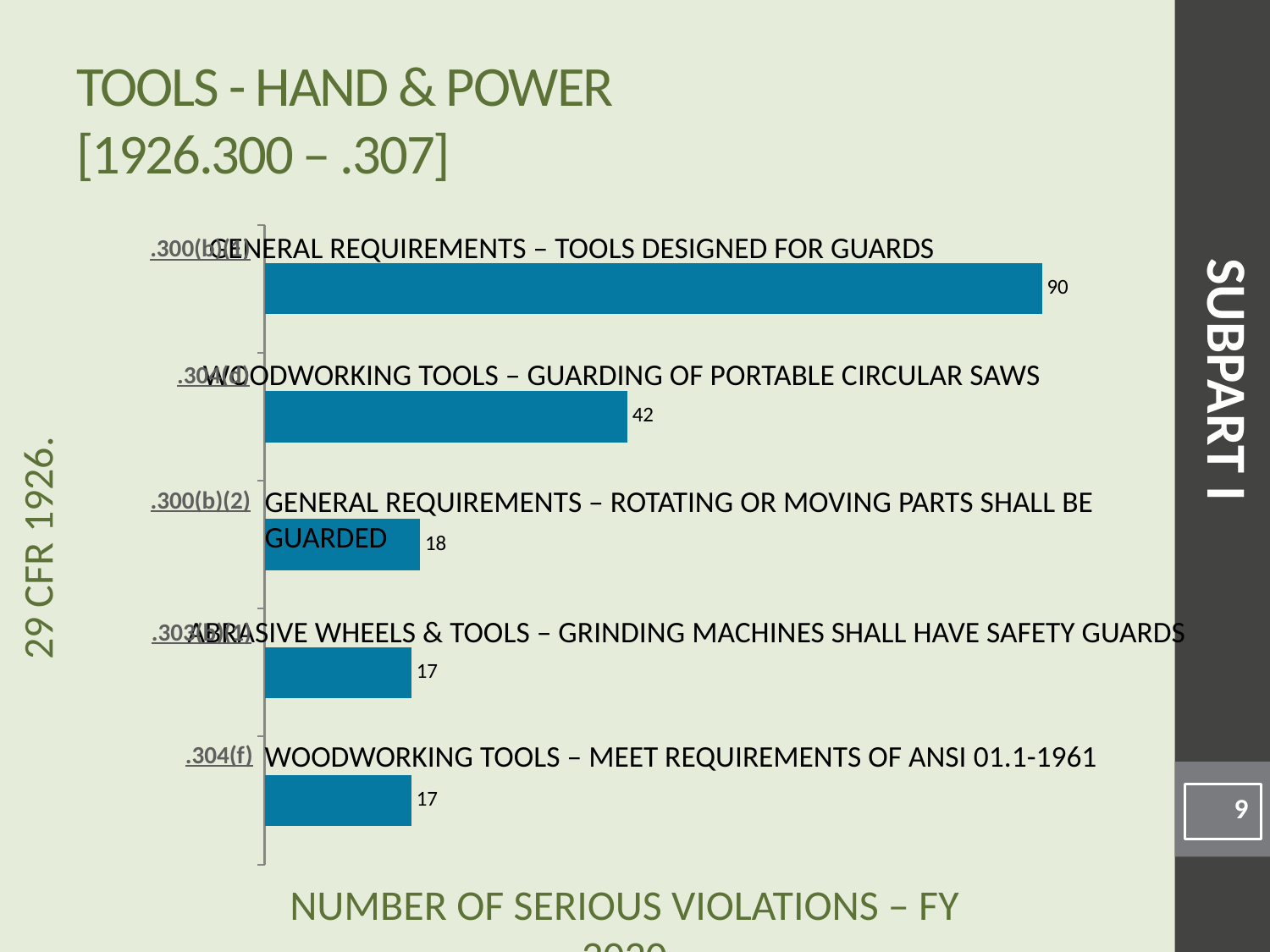
What is the value for Woodworking Tools – Guarding of Portable Circular Saws? 42 What is the difference between the values for Woodworking Tools – Guarding of Portable Circular Saws and .300(b)(2) Rotating or Moving Parts Shall Be Guarded? 24 What is the value for .304(f) Woodworking Tools – Meet Requirements of ANSI 01.1-1961? 17 How many serious violations are shown for General Requirements – Tools Designed for Guards? 90 Which is larger: the value for Woodworking Tools – Guarding of Portable Circular Saws or the value for .300(b)(2) Rotating or Moving Parts Shall Be Guarded? Woodworking Tools – Guarding of Portable Circular Saws What kind of chart is shown on the slide? Bar chart What is the lowest value shown on the chart? 17 What is the value for .300(b)(2) General Requirements – Rotating or Moving Parts Shall Be Guarded? 18 Which category has the highest number of serious violations? General Requirements – Tools Designed for Guards What is the difference between the values for General Requirements – Tools Designed for Guards and Woodworking Tools – Guarding of Portable Circular Saws? 48 How many serious violations are shown for Abrasive Wheels & Tools – Grinding Machines Shall Have Safety Guards? 17 How many categories are plotted on the chart? 5